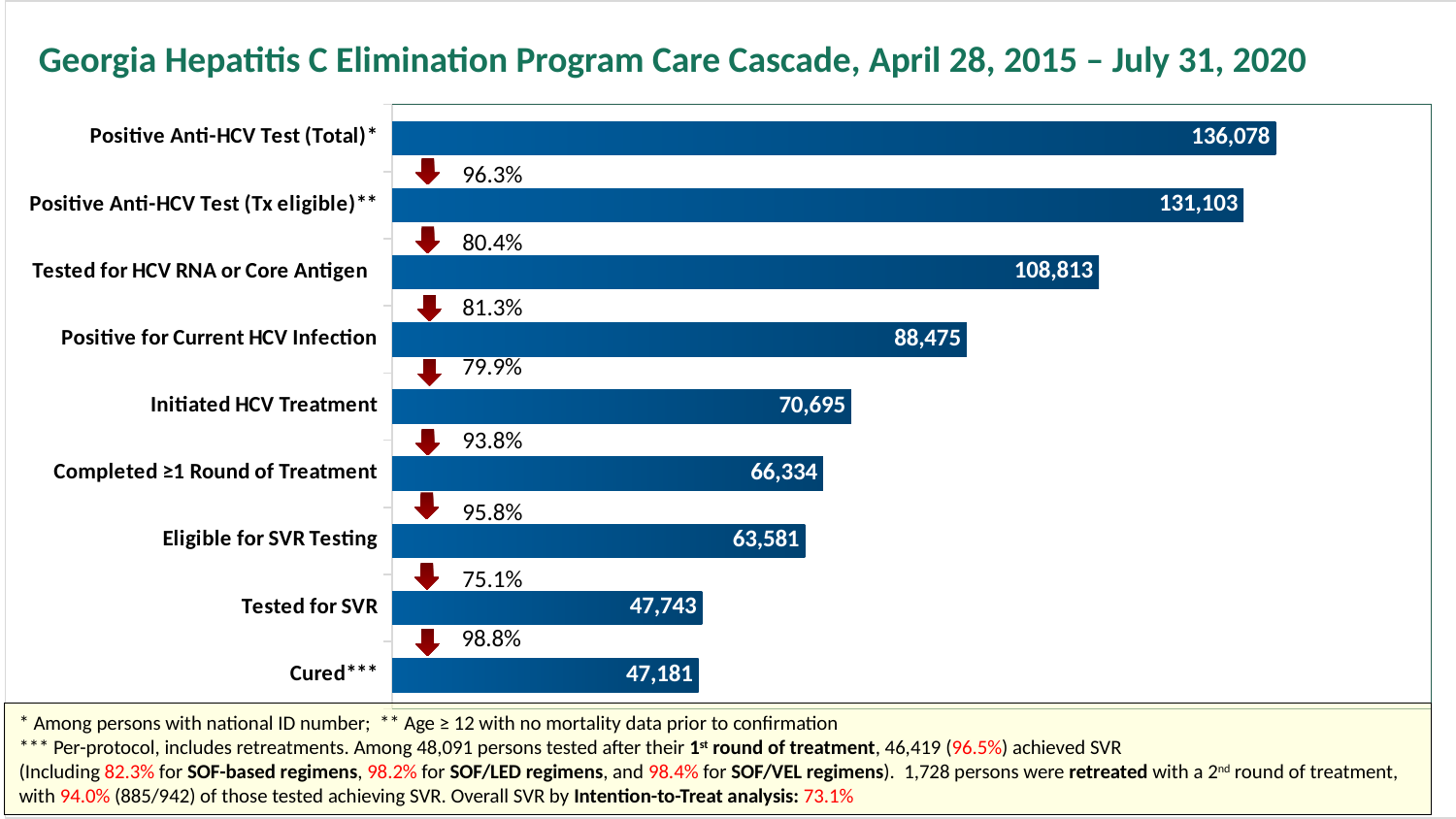
Which category has the lowest value? Cured What kind of chart is this? Bar chart What is the value for Cured? 47,181 How many categories are shown in the chart? 9 Which category has the highest value? Positive Anti-HCV Test (Total) Which is larger, Completed ≥1 Round of Treatment or Eligible for SVR Testing? Completed ≥1 Round of Treatment What is the value for Positive Anti-HCV Test (Total)? 136,078 What percentage is shown between Tested for SVR and Cured? 98.8% What is the difference between Positive for Current HCV Infection and Initiated HCV Treatment? 17,780 What is the value for Initiated HCV Treatment? 70,695 What is the difference between Tested for SVR and Cured? 562 What is the value for Tested for HCV RNA or Core Antigen? 108,813